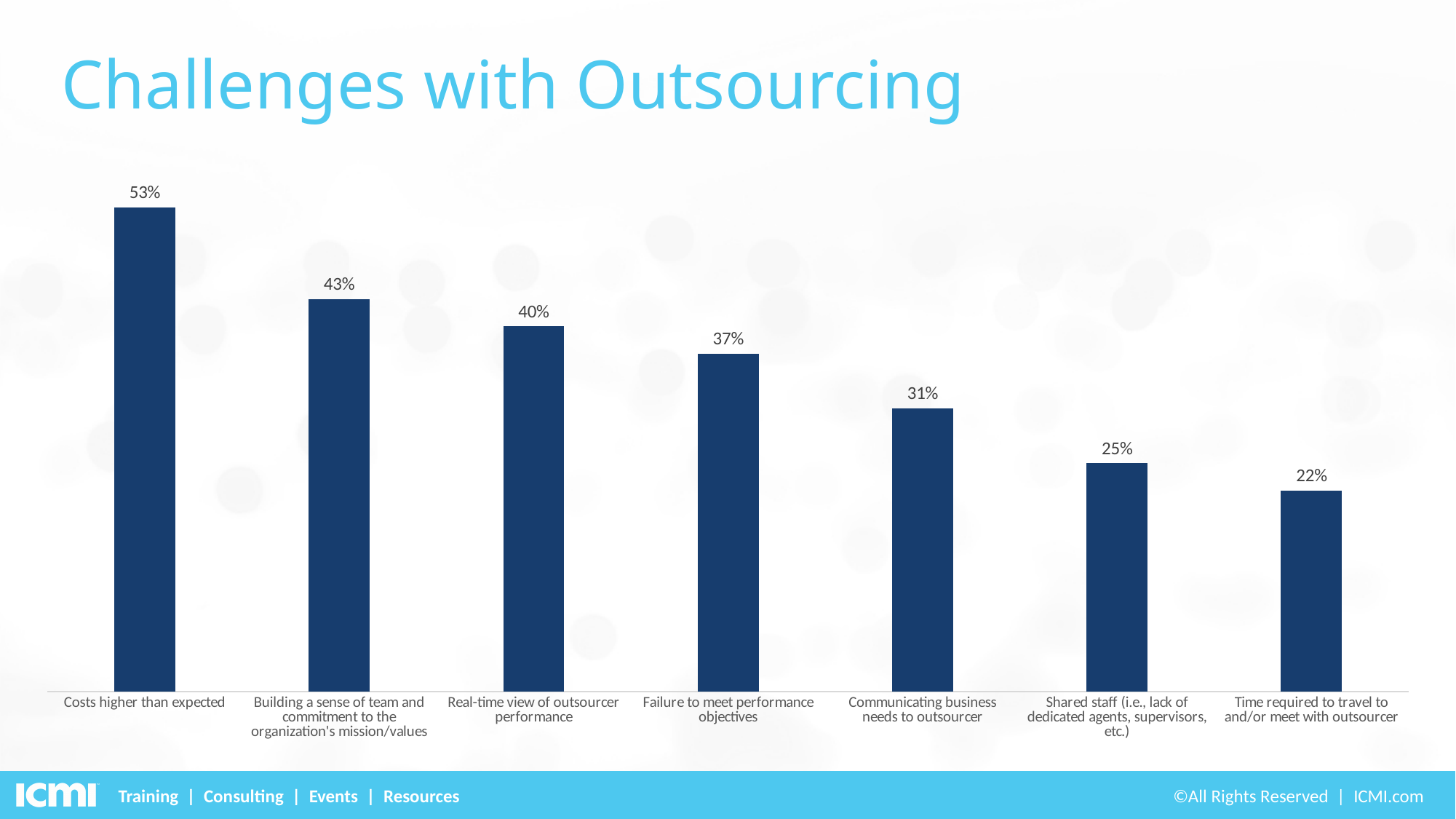
What is the difference between "Building a sense of team and commitment to the organization's mission/values" and "Shared staff (i.e., lack of dedicated agents, supervisors, etc.)"? 18% Do the values rise or fall from left to right across the chart? Fall What is the value for "Time required to travel to and/or meet with outsourcer"? 22% Which is larger: "Failure to meet performance objectives" or "Communicating business needs to outsourcer"? Failure to meet performance objectives Which challenge has the lowest value? Time required to travel to and/or meet with outsourcer What is the difference between "Costs higher than expected" and "Failure to meet performance objectives"? 16% What kind of chart is shown on the slide? Bar chart Which challenge has the highest value? Costs higher than expected What is the value for "Real-time view of outsourcer performance"? 40% What is the value for "Costs higher than expected"? 53% How many challenges are shown in the chart? 7 What is the value for "Communicating business needs to outsourcer"? 31%